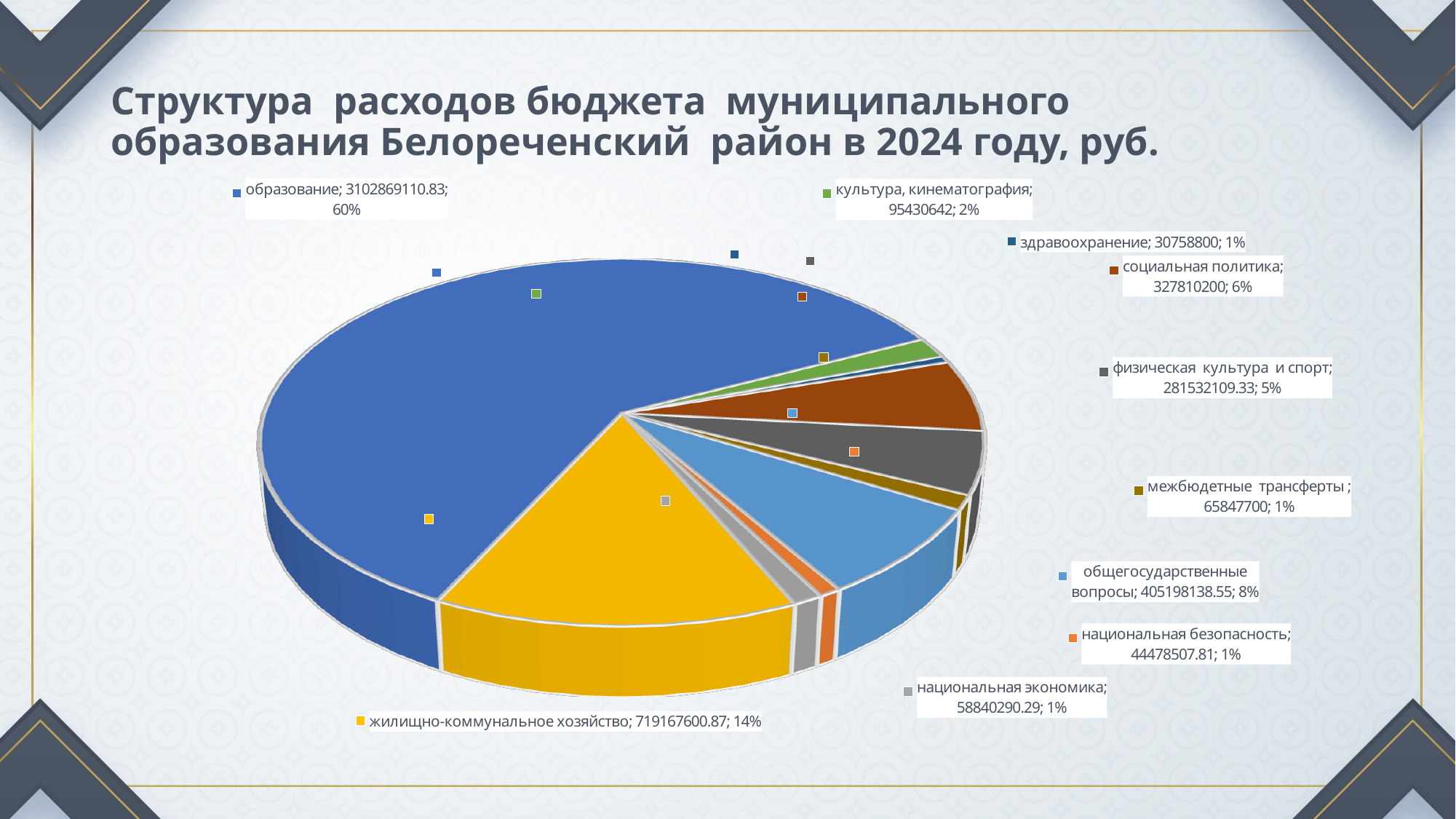
What is the value for образование? 3102869110.83 What is the difference between the values for социальная политика and физическая культура и спорт? 46278090.67 What is the value for жилищно-коммунальное хозяйство? 719167600.87 How many categories does the pie chart show? 10 What share of the pie does физическая культура и спорт take? 5% What is the title of the chart on the slide? Структура расходов бюджета муниципального образования Белореченский район в 2024 году, руб. Which category has the largest share of the pie? образование What share of the pie does общегосударственные вопросы take? 8% Which is larger: общегосударственные вопросы or жилищно-коммунальное хозяйство? жилищно-коммунальное хозяйство Which category has the smallest value? здравоохранение What kind of chart is shown on the slide? pie chart What is the value for социальная политика? 327810200